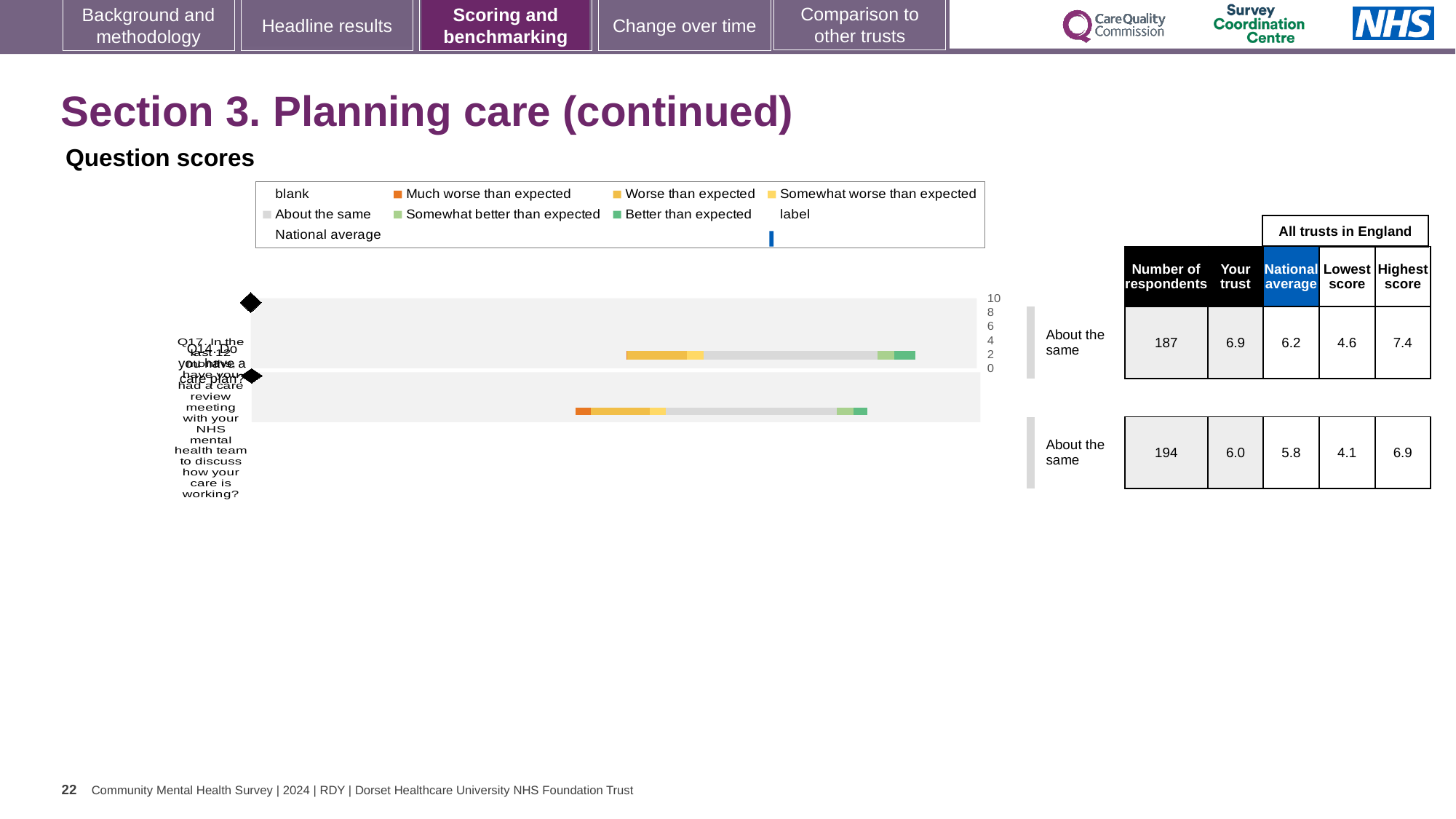
In the chart legend, what colour represents 'Much worse than expected'? orange In the table beside the chart, how many respondents are listed for the second (bottom) question row? 194 In the table beside the chart, what is the 'Lowest score' for the second (bottom) question row? 4.1 In the chart legend, what colour represents 'Better than expected'? green In the table beside the chart, what is the 'Highest score' for the first (top) question row? 7.4 How many question bars are plotted in the chart? 2 In the table beside the chart, what is the 'Your trust' score for the first (top) question row? 6.9 In the table beside the chart, which question row has the higher 'Your trust' score, the first (top) or the second (bottom)? the first (top) In the table beside the chart, what is the difference between 'Your trust' and 'National average' for the first (top) question row? 0.7 What kind of chart is shown under 'Question scores'? bar chart What benchmark category is shown next to both question rows in the table beside the chart? About the same In the table beside the chart, what is the 'National average' for the second (bottom) question row? 5.8